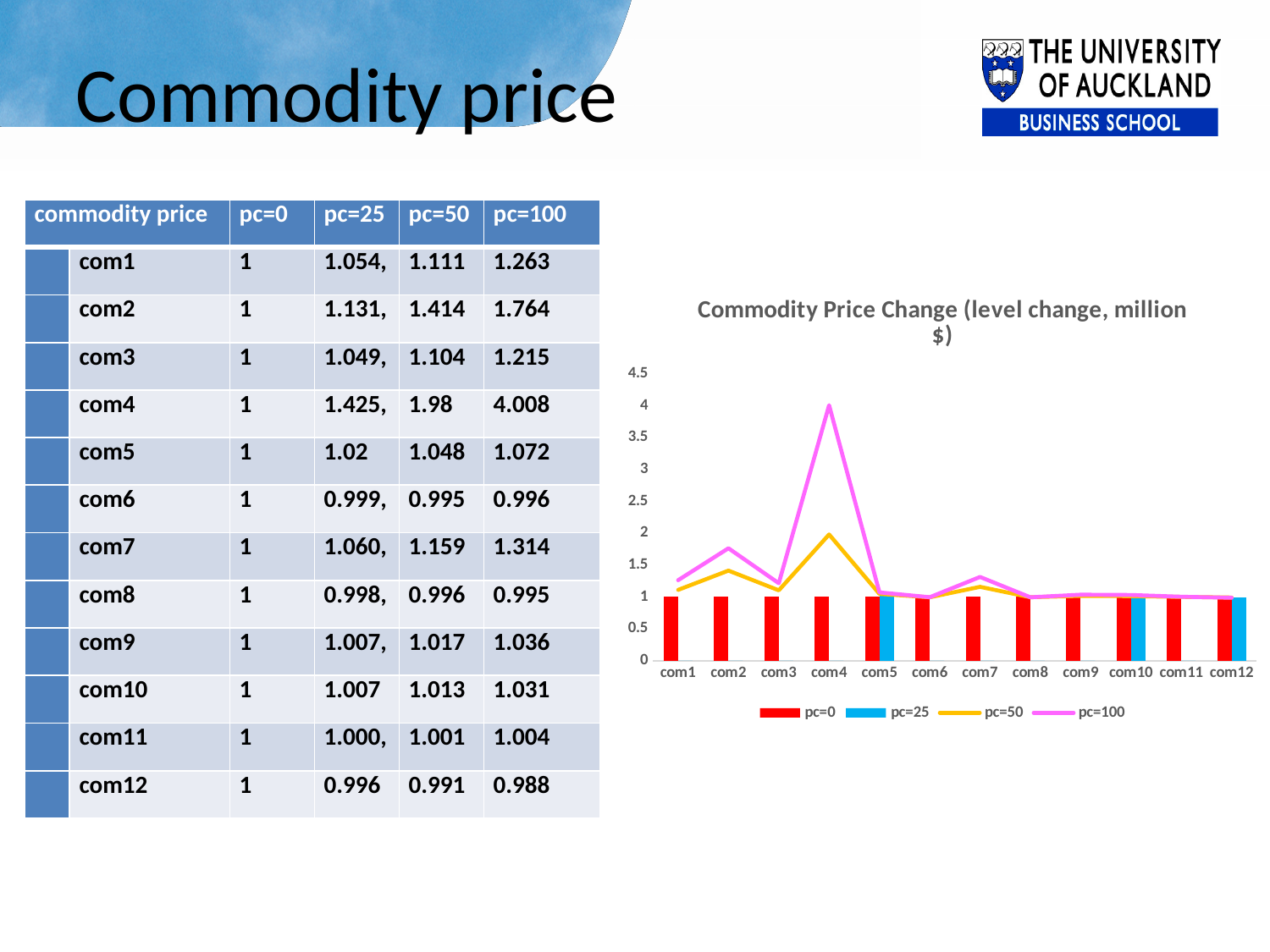
How many series does the chart legend list? 4 Which has the larger pc=50 value, com2 or com3? com2 Is the pc=100 value for com4 greater or less than 3.5? greater What is the value of the pc=0 bar for com1 in the chart? 1 Which series is drawn as a pink line in the chart? pc=100 For which commodity does the pc=50 line reach its highest value? com4 What kind of chart is shown on the slide? Combined bar and line chart How many commodity categories are shown on the x axis of the chart? 12 Is the pc=100 value for com1 greater or less than 1.5? less Is the pc=100 value for com2 greater or less than 1.5? greater For which commodity does the pc=100 line reach its highest value? com4 What is the title of the chart? Commodity Price Change (level change, million $)